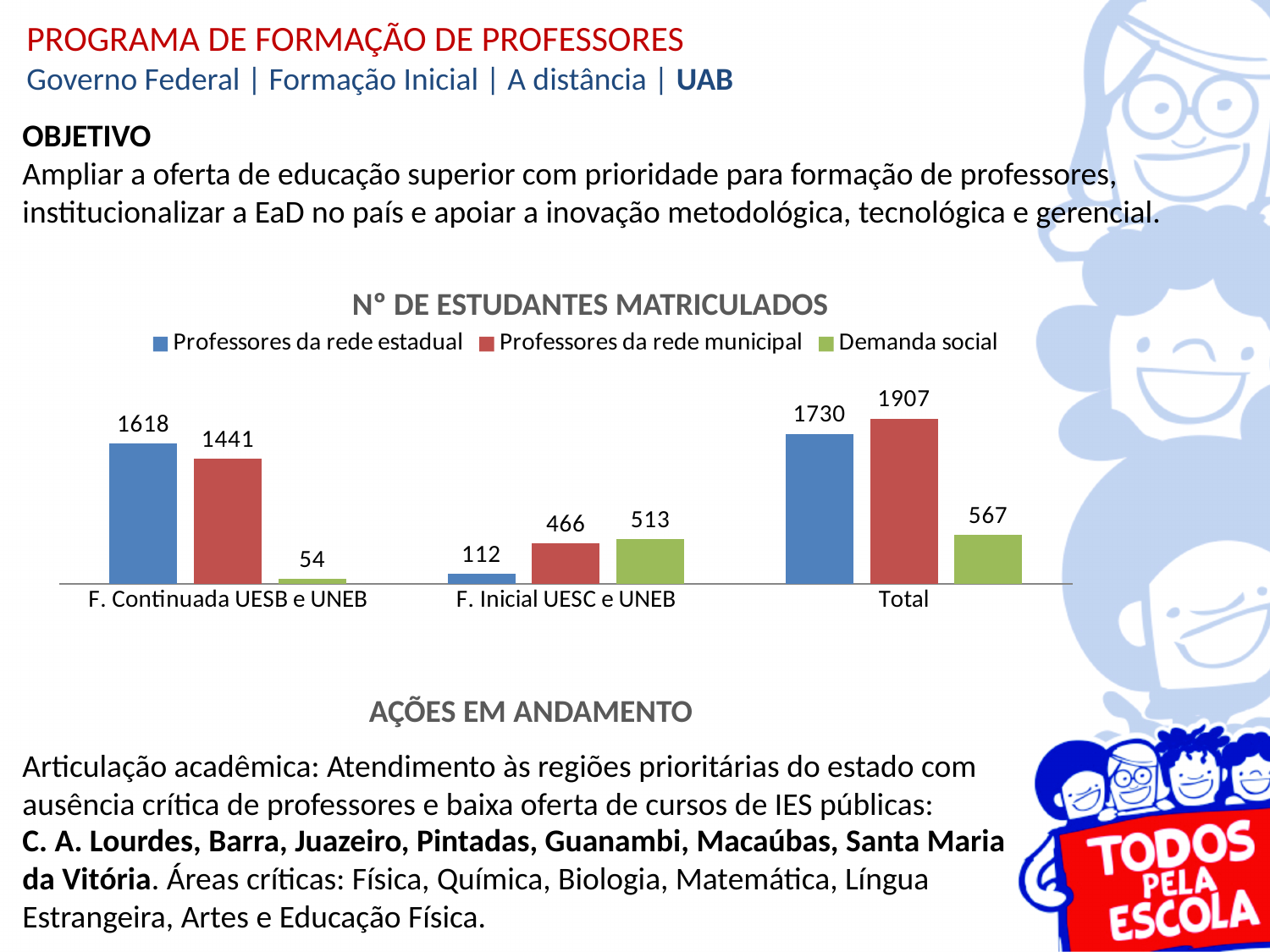
What is the value for Professores da rede estadual in the F. Continuada UESB e UNEB category? 1618 How many categories are shown on the x axis? 3 Which is larger in the F. Inicial UESC e UNEB category: Professores da rede municipal or Demanda social? Demanda social What is the title of the chart? Nº DE ESTUDANTES MATRICULADOS What is the value for Demanda social in the F. Inicial UESC e UNEB category? 513 What is the difference between Professores da rede estadual and Professores da rede municipal in the F. Continuada UESB e UNEB category? 177 What is the difference between Demanda social in the Total category and Demanda social in the F. Continuada UESB e UNEB category? 513 How many series does the legend list? 3 Which series has the highest value in the Total category? Professores da rede municipal Which series has the lowest value in the F. Continuada UESB e UNEB category? Demanda social What kind of chart is shown on the slide? Bar chart What is the value for Professores da rede municipal in the Total category? 1907